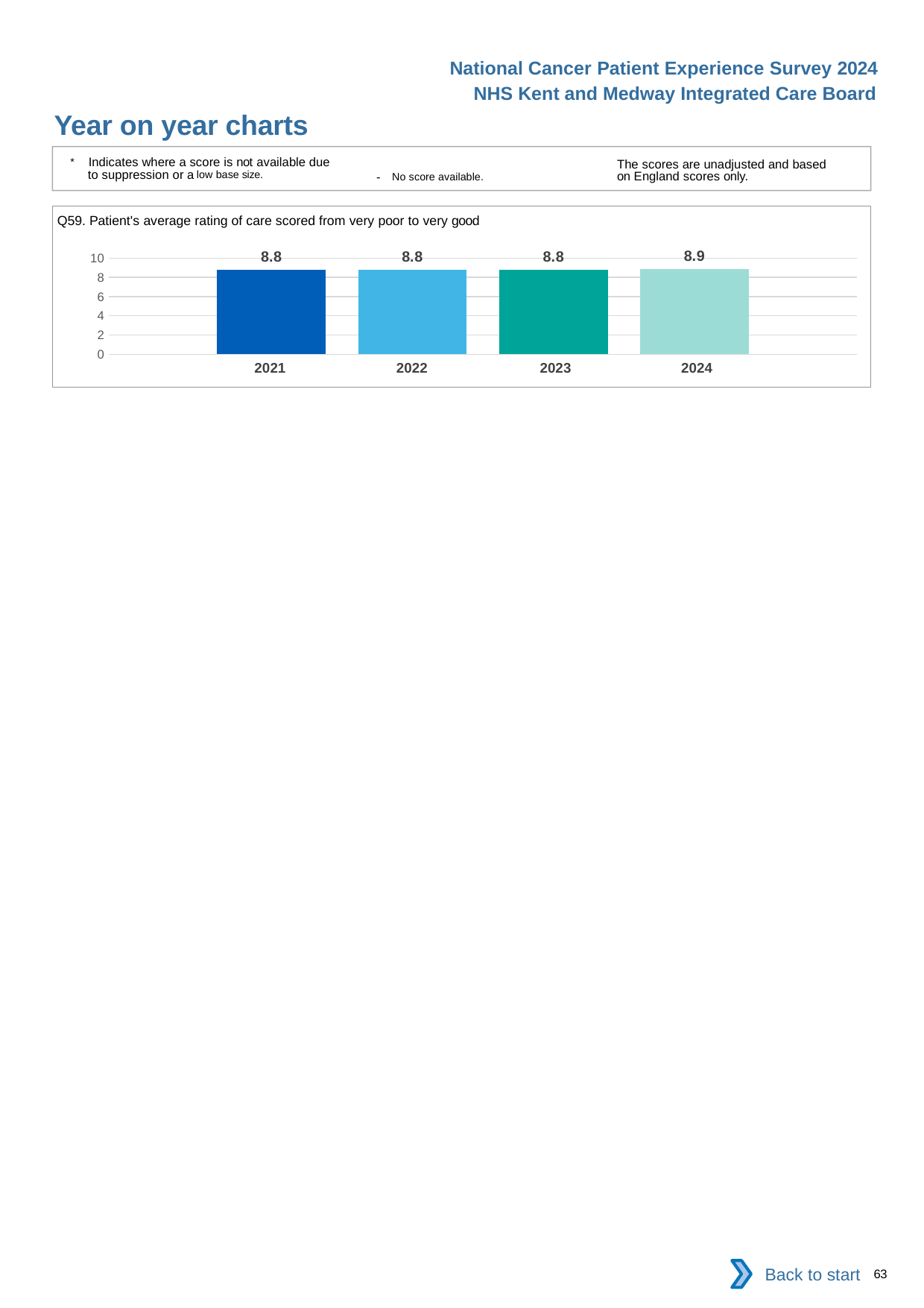
What is the title of the chart? Q59. Patient's average rating of care scored from very poor to very good Which year has the highest value? 2024 What is the value for 2024? 8.9 What is the value for 2021? 8.8 What kind of chart is shown? bar chart What is the difference between the values for 2024 and 2022? 0.1 What is the value for 2023? 8.8 What is the maximum value shown on the y axis? 10 Which is larger, the value for 2024 or the value for 2021? 2024 Is the value for 2022 greater or less than 6? greater Do the values rise or fall from 2023 to 2024? rise How many years are shown on the chart? 4